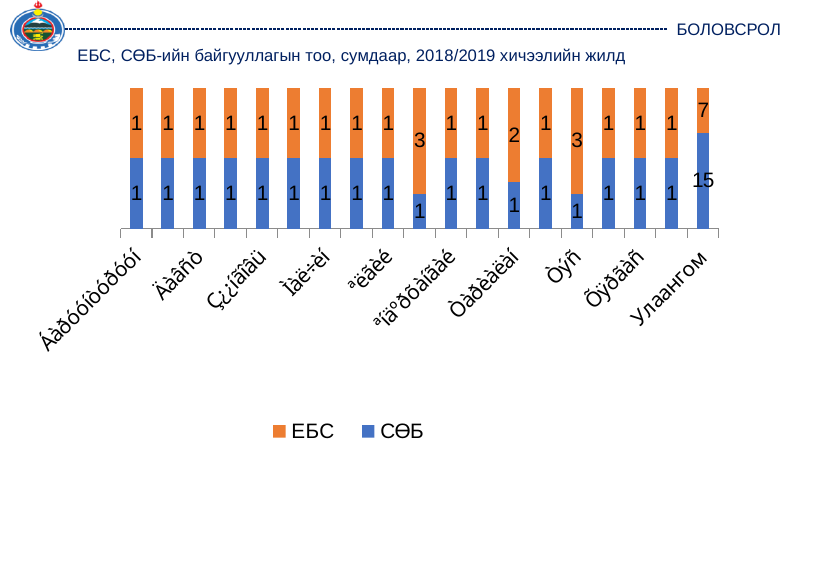
What are the two series named in the legend? ЕБС and СӨБ How many series does the legend list? 2 What kind of chart is shown on the slide? Stacked bar chart What is the СӨБ value for Улаангом? 15 What is the title of the chart? ЕБС, СӨБ-ийн байгууллагын тоо, сумдаар, 2018/2019 хичээлийн жилд For Улаангом, what is the difference between the СӨБ value and the ЕБС value? 8 How many categories (bars) are plotted along the x axis? 19 Which category has the highest ЕБС value? Улаангом What is the ЕБС value for Улаангом? 7 For Улаангом, which is larger: the ЕБС value or the СӨБ value? СӨБ What is the total height of the stacked bar for Улаангом? 22 Which category has the highest СӨБ value? Улаангом